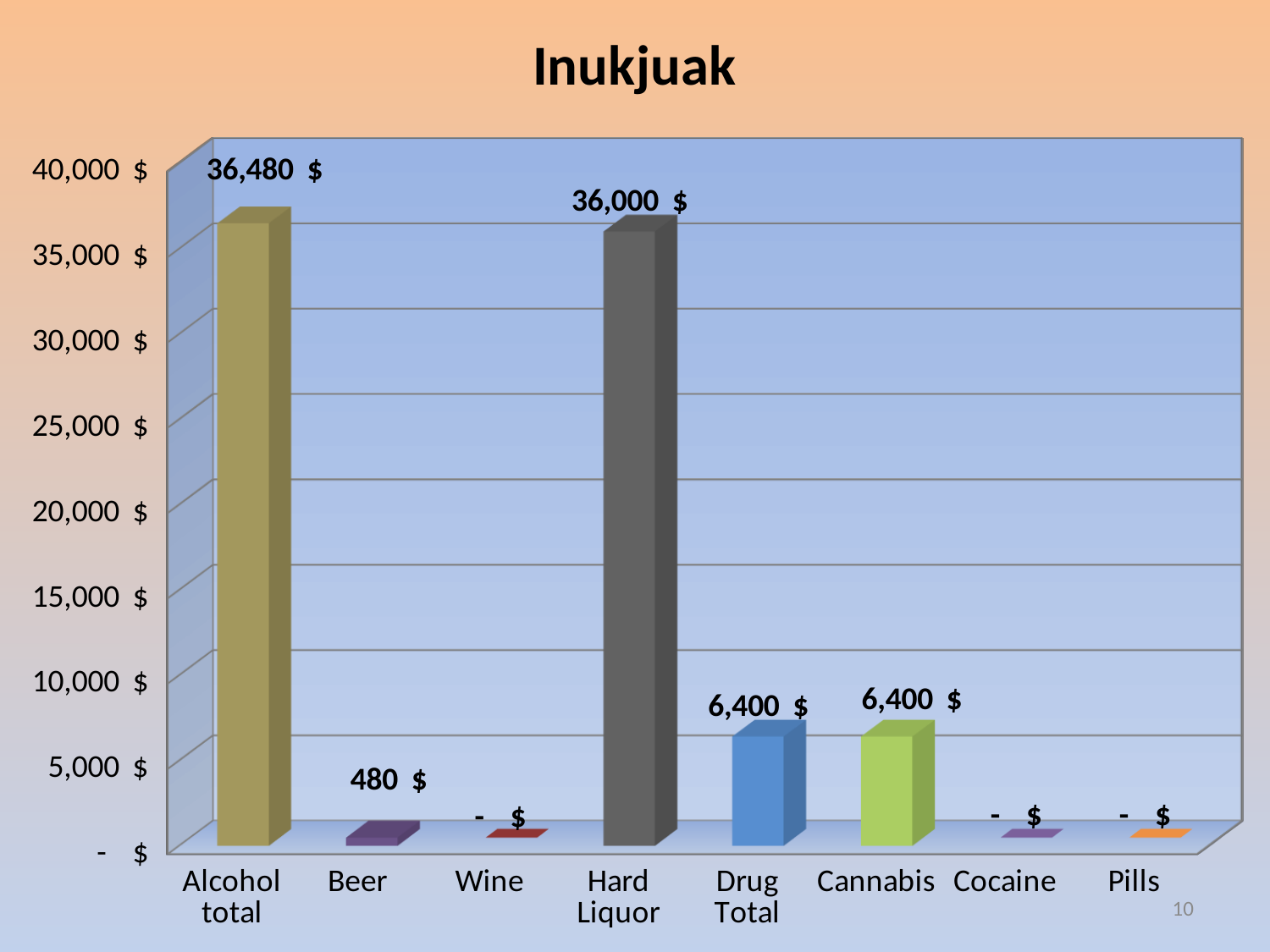
What is the value for Beer? 480 $ Is the value for Hard Liquor greater or less than 35,000? greater What is the difference between Alcohol total and Hard Liquor? 480 $ What is the value for Cannabis? 6,400 $ What is the value for Alcohol total? 36,480 $ What kind of chart is shown? bar chart How many categories are shown on the x axis? 8 What is the title of the chart? Inukjuak Which category has the highest value? Alcohol total Which is larger, Hard Liquor or Drug Total? Hard Liquor What is the value for Hard Liquor? 36,000 $ What is the difference between Drug Total and Beer? 5,920 $